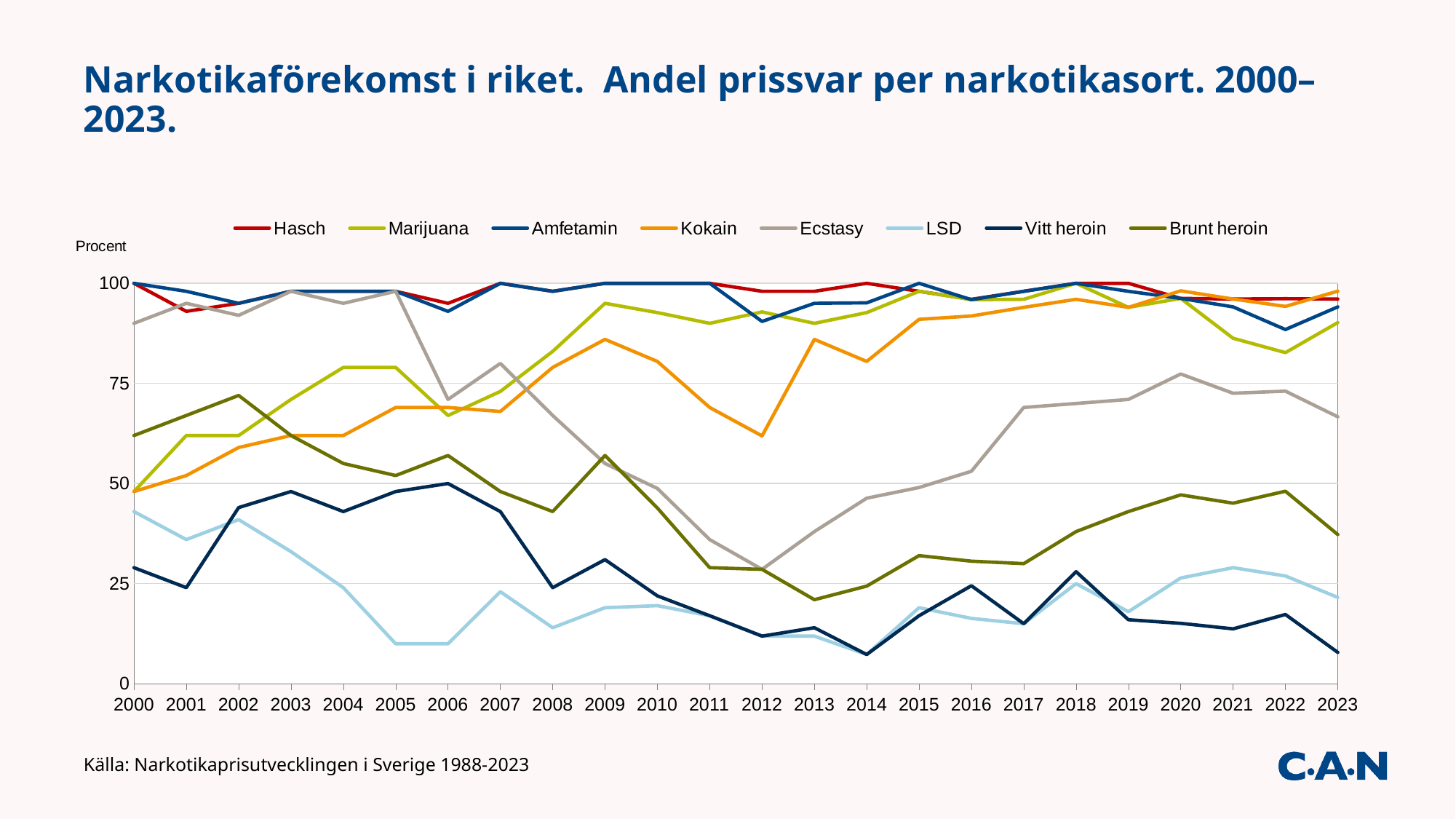
Is the value for Marijuana in 2009 greater or less than 75? greater Is the value for Vitt heroin in 2023 greater or less than 25? less How many years are plotted along the x axis? 24 Is the value for LSD in 2005 greater or less than 25? less In 2005, which is larger: Ecstasy or Brunt heroin? Ecstasy Does the Kokain line overall rise or fall from 2000 to 2023? rise How many series does the legend list? 8 What label is shown on the y axis? Procent What kind of chart is shown on the slide? line chart What is the value for Hasch in 2000? 100 Which series has the lowest value in 2023? Vitt heroin